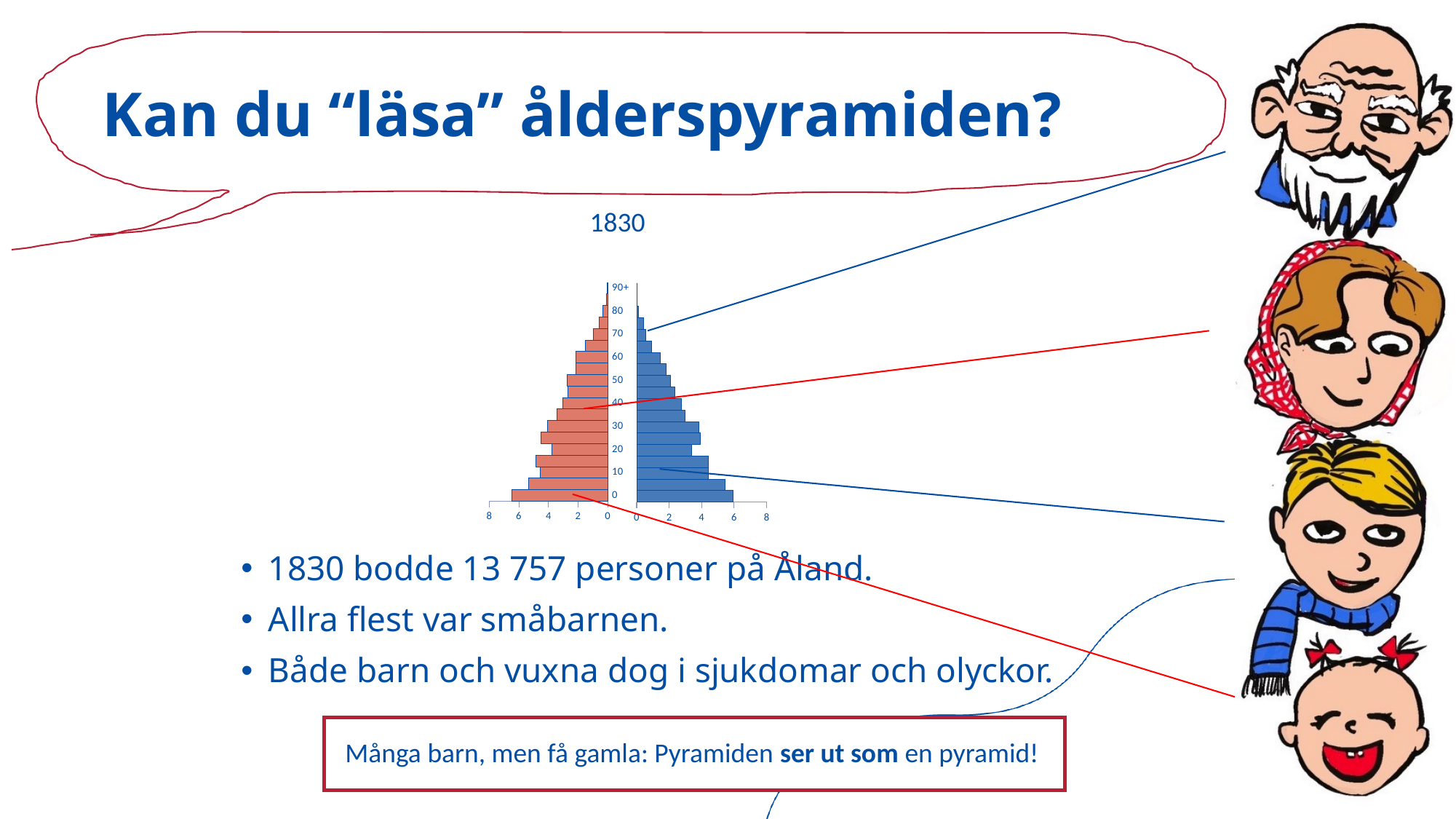
What kind of chart is shown on the slide? bar chart Which age group has the shortest red bar? 90+ What is the highest value shown on the horizontal axis? 8 Do the bars get longer or shorter as the age groups increase from 0 to 90+? shorter Which age group has the longest red bar? 0 Is the red bar for age group 50 greater or less than 4? less Is the red bar for age group 0 greater or less than 4? greater What is the title of the chart? 1830 Is the blue bar for age group 80 greater or less than 2? less Which is longer, the red bar for age group 0 or the red bar for age group 60? age group 0